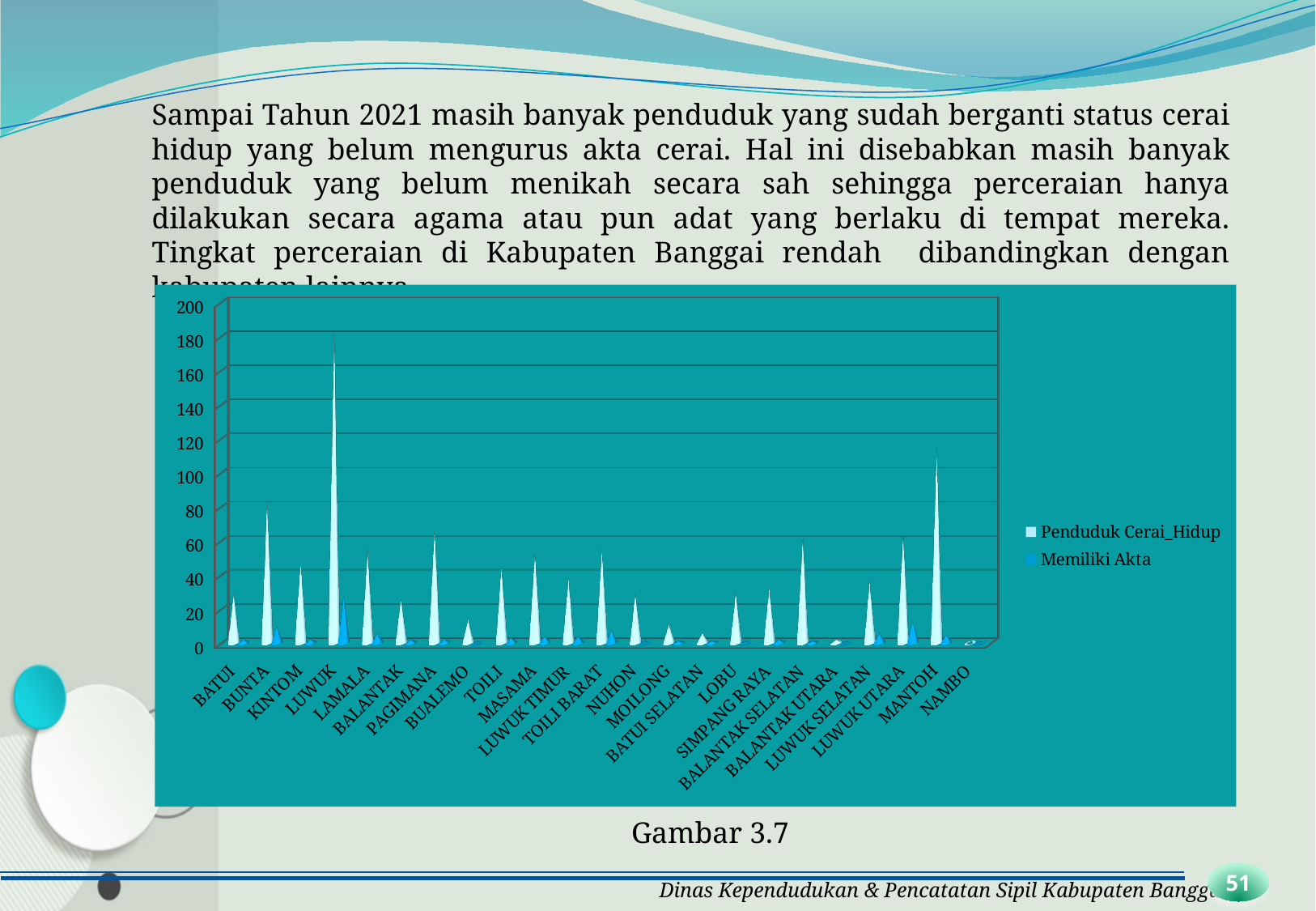
What are the two series named in the legend? Penduduk Cerai_Hidup and Memiliki Akta Is the Penduduk Cerai_Hidup value for LUWUK greater or less than 160? greater Which category has the highest value for Penduduk Cerai_Hidup? LUWUK How many categories are shown on the x axis? 23 What kind of chart is shown on the slide? bar chart Is the Penduduk Cerai_Hidup value for BUNTA greater or less than 60? greater Which has the larger Penduduk Cerai_Hidup value, BUNTA or KINTOM? BUNTA Is the Penduduk Cerai_Hidup value for MANTOH greater or less than 100? greater What is the figure caption shown below the chart? Gambar 3.7 Which has the larger Penduduk Cerai_Hidup value, LUWUK or MANTOH? LUWUK How many series does the legend list? 2